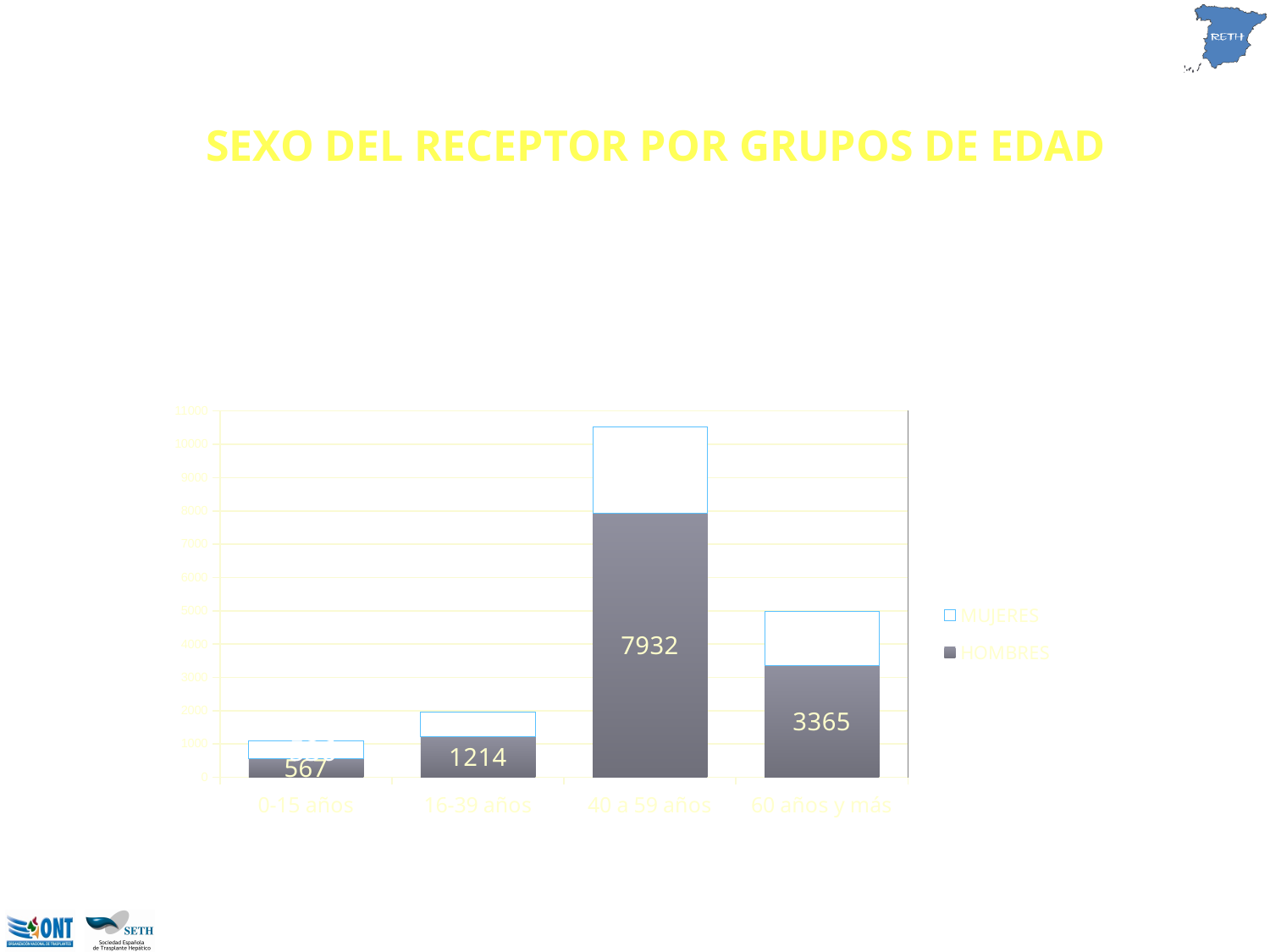
Is the total height of the stacked bar for 40 a 59 años greater or less than 10000? greater What is the HOMBRES value for the 40 a 59 años group? 7932 Which age group has the lowest HOMBRES value? 0-15 años What kind of chart is shown on the slide? stacked bar chart What is the HOMBRES value for the 60 años y más group? 3365 Which age group has the highest HOMBRES value? 40 a 59 años Which is larger, the HOMBRES value for 16-39 años or for 0-15 años? 16-39 años What is the HOMBRES value for the 16-39 años group? 1214 What is the HOMBRES value for the 0-15 años group? 567 How many age groups are shown on the x axis? 4 What is the difference between the HOMBRES values for 40 a 59 años and 60 años y más? 4567 How many series does the legend list? 2